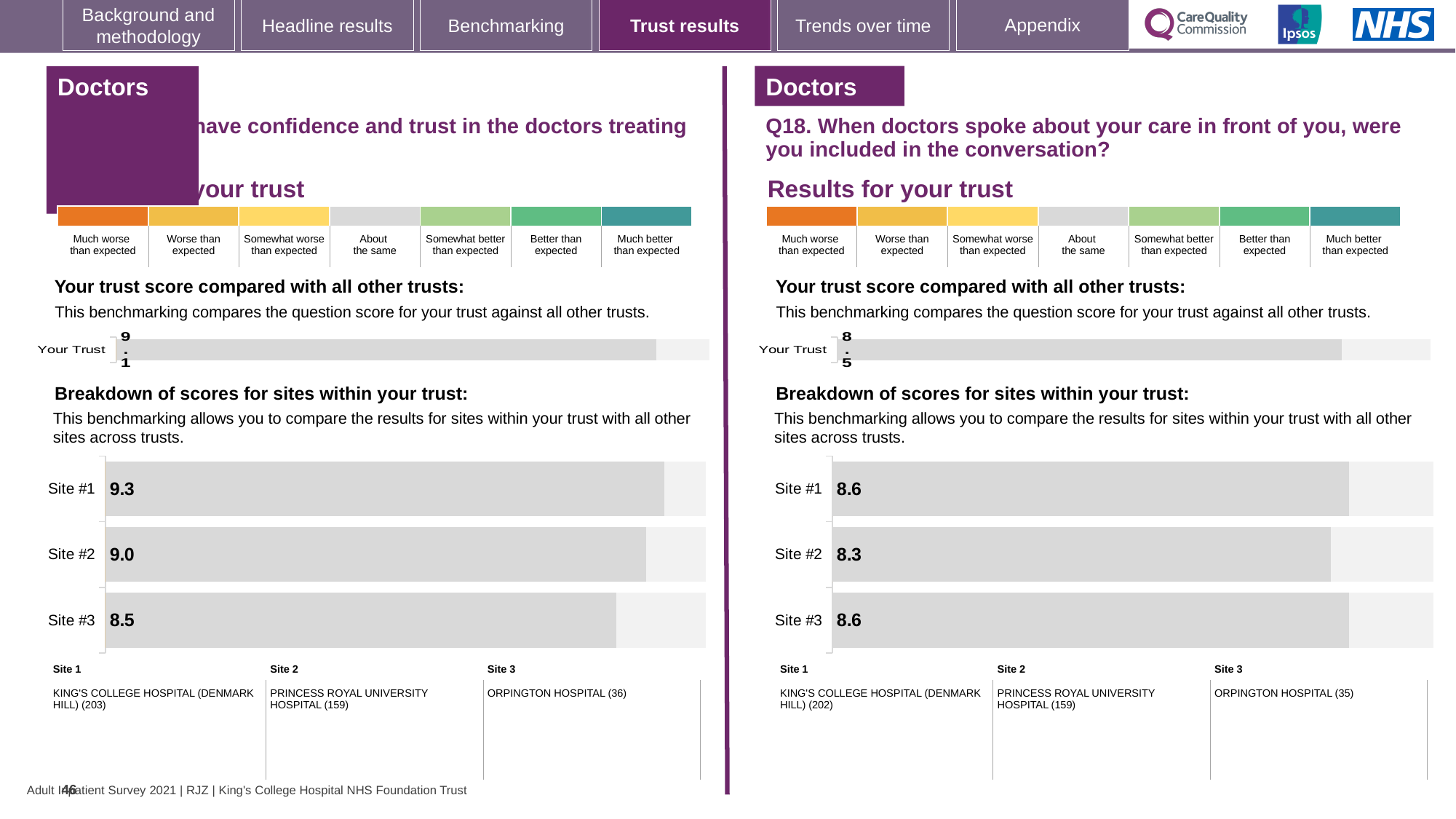
On the Q18 'Breakdown of scores for sites within your trust' chart, what is the score for Site #2? 8.3 On the Q18 'Breakdown of scores for sites within your trust' chart, what is the difference between the scores for Site #1 and Site #2? 0.3 On the left-hand 'Breakdown of scores for sites within your trust' chart, which site has the highest score? Site #1 On the Q18 'Your trust score compared with all other trusts' chart, what is the score for Your Trust? 8.5 On the left-hand 'Breakdown of scores for sites within your trust' chart, what is the score for Site #3? 8.5 On the left-hand 'Breakdown of scores for sites within your trust' chart, what is the score for Site #1? 9.3 On the Q18 'Breakdown of scores for sites within your trust' chart, how many sites are shown? 3 On the left-hand 'Your trust score compared with all other trusts' chart, what is the score for Your Trust? 9.1 What type of chart is used for the 'Breakdown of scores for sites within your trust' on the left-hand side of the slide? Bar chart On the left-hand 'Breakdown of scores for sites within your trust' chart, which site has the lowest score? Site #3 On the left-hand 'Breakdown of scores for sites within your trust' chart, what is the difference between the scores for Site #1 and Site #3? 0.8 On the Q18 'Breakdown of scores for sites within your trust' chart, which site has the lowest score? Site #2